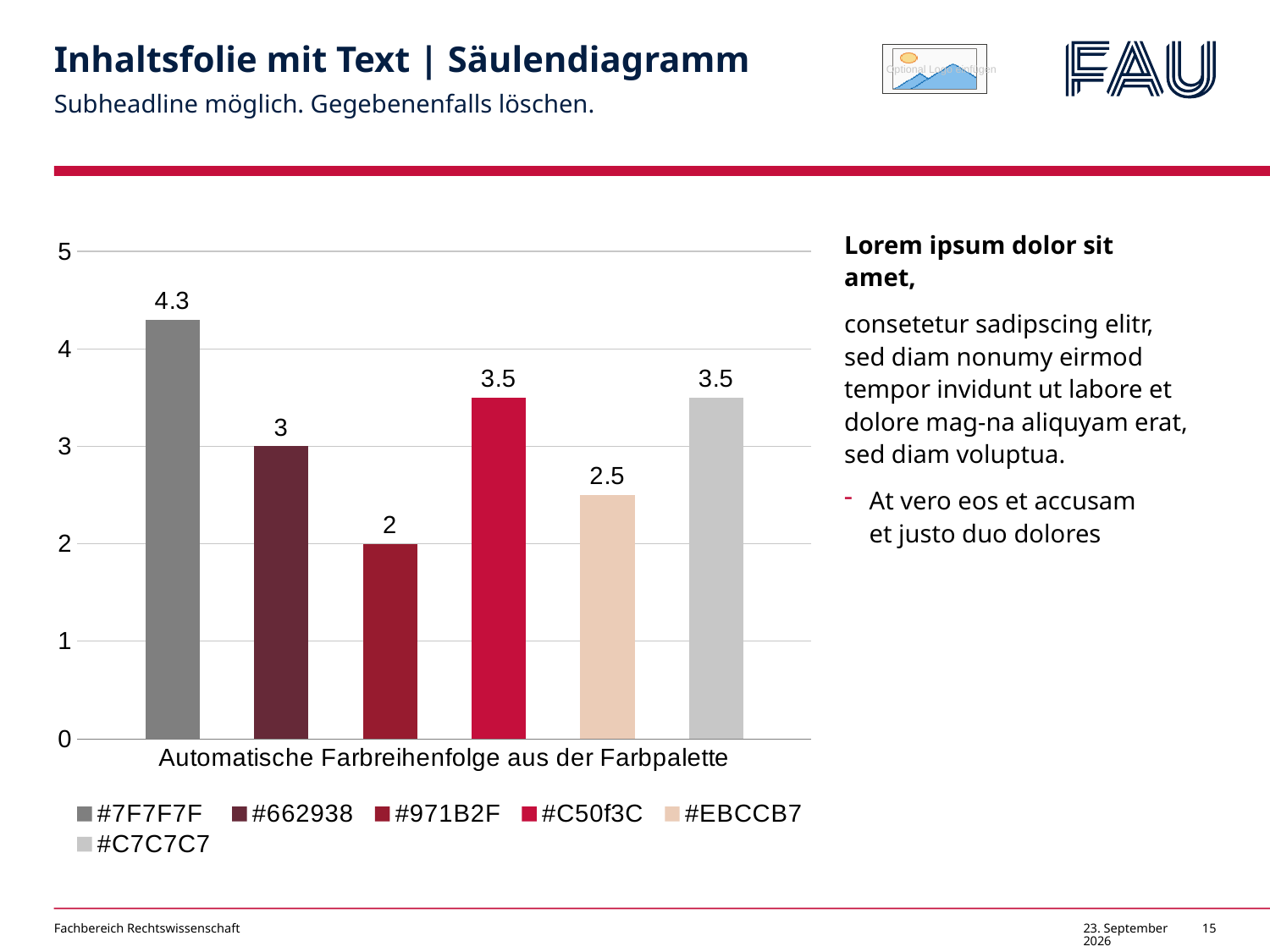
Which series has the lowest value? #971B2F What is the value of the #7F7F7F series? 4.3 What kind of chart is shown on the slide? bar chart Which series has the highest value? #7F7F7F What is the value of the #971B2F series? 2 Is the value for #7F7F7F greater or less than 4? greater What is the value of the #EBCCB7 series? 2.5 Which is larger, the value for #C50f3C or the value for #EBCCB7? #C50f3C What is the category label shown on the x axis? Automatische Farbreihenfolge aus der Farbpalette What is the value of the #662938 series? 3 What is the difference between the #7F7F7F value and the #662938 value? 1.3 How many series does the legend list? 6